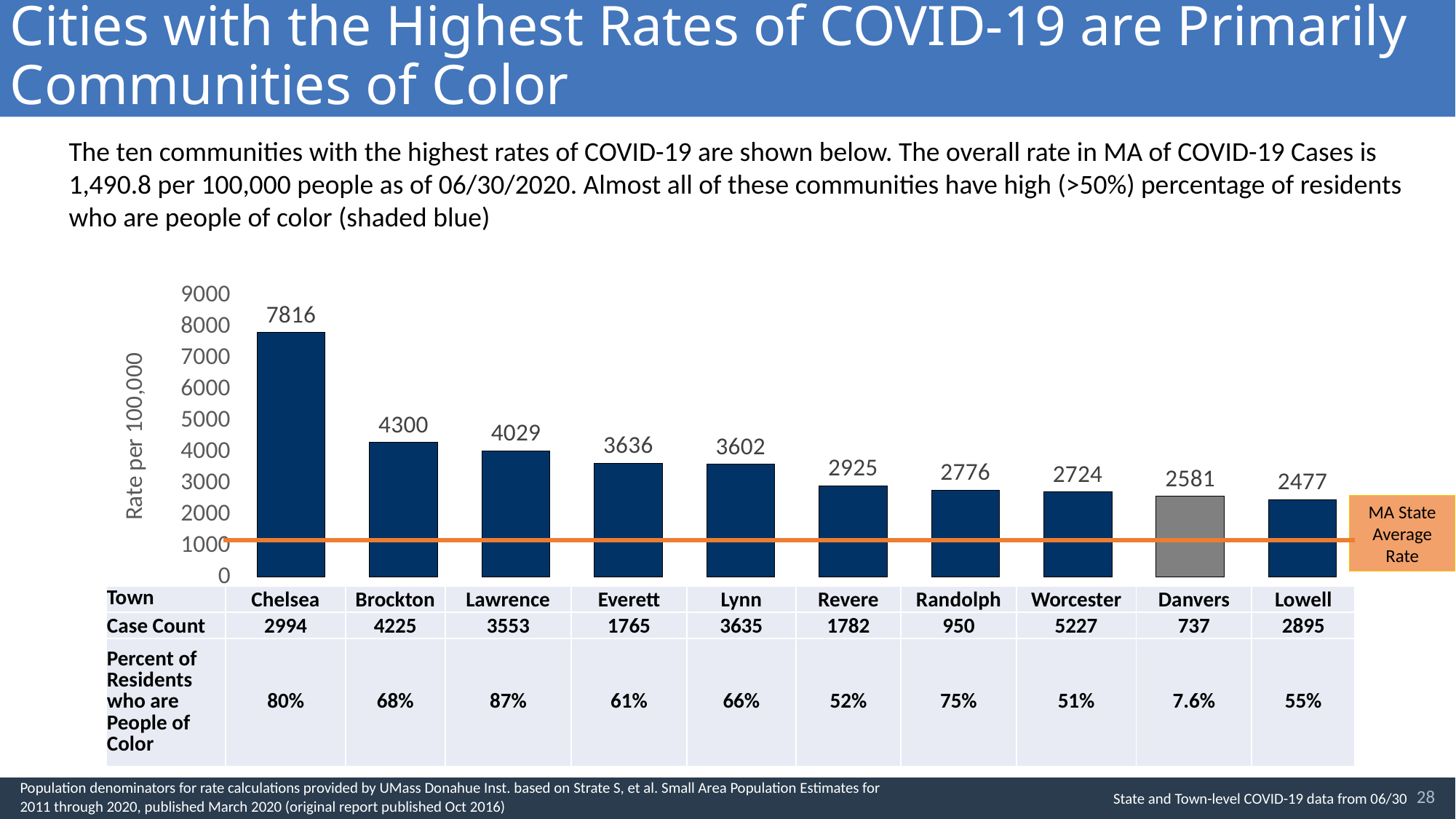
Which has a higher rate per 100,000, Everett or Revere? Everett Which town's bar is shaded grey instead of blue? Danvers What is the rate per 100,000 for Chelsea? 7816 How many towns are shown in the bar chart? 10 What is the rate per 100,000 for Worcester? 2724 What kind of chart is used to show the rates per 100,000? bar chart Which town has the highest rate per 100,000? Chelsea Is the rate for Danvers greater or less than 3000? less Do the rates rise or fall moving from left to right across the towns? fall What does the orange horizontal line on the chart represent? MA State Average Rate What is the difference between the rates for Brockton and Lawrence? 271 Which town has the lowest rate per 100,000 among those shown? Lowell